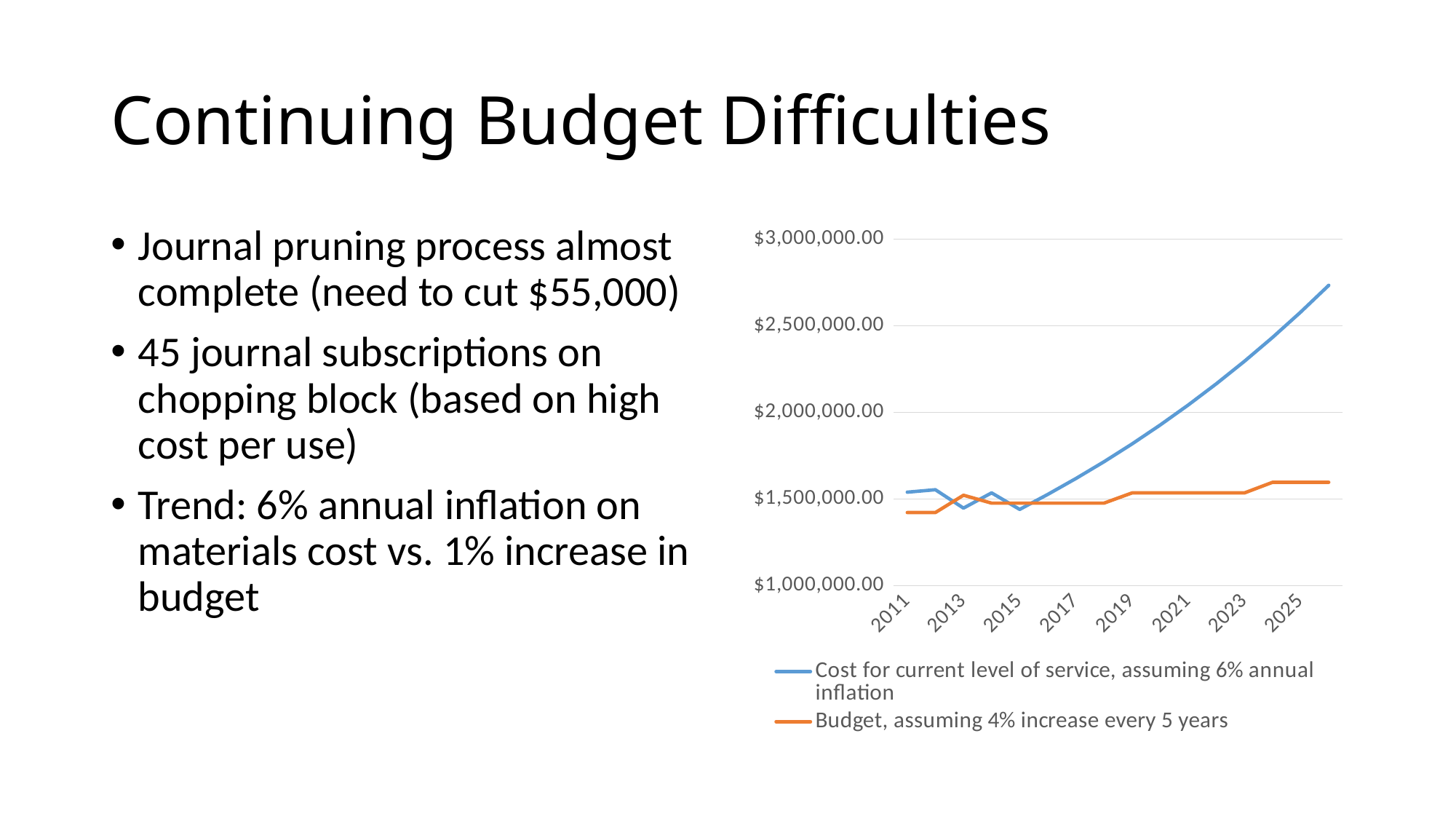
What are the two series named in the chart's legend? Cost for current level of service, assuming 6% annual inflation; Budget, assuming 4% increase every 5 years Is the value of 'Cost for current level of service, assuming 6% annual inflation' in 2019 greater or less than $1,500,000.00? greater Is the value of 'Cost for current level of service, assuming 6% annual inflation' in 2023 greater or less than $2,000,000.00? greater In 2025, which series has the higher value: the cost for current level of service or the budget? Cost for current level of service, assuming 6% annual inflation Is the value of 'Budget, assuming 4% increase every 5 years' in 2011 greater or less than $1,500,000.00? less How many series does the chart's legend list? 2 What is the highest value shown on the chart's y axis? $3,000,000.00 Does the 'Cost for current level of service, assuming 6% annual inflation' line generally rise or fall from 2017 to 2025? rise How many year labels are shown on the chart's x axis? 8 What colour is the line for 'Budget, assuming 4% increase every 5 years'? orange What kind of chart is shown on the slide? line chart